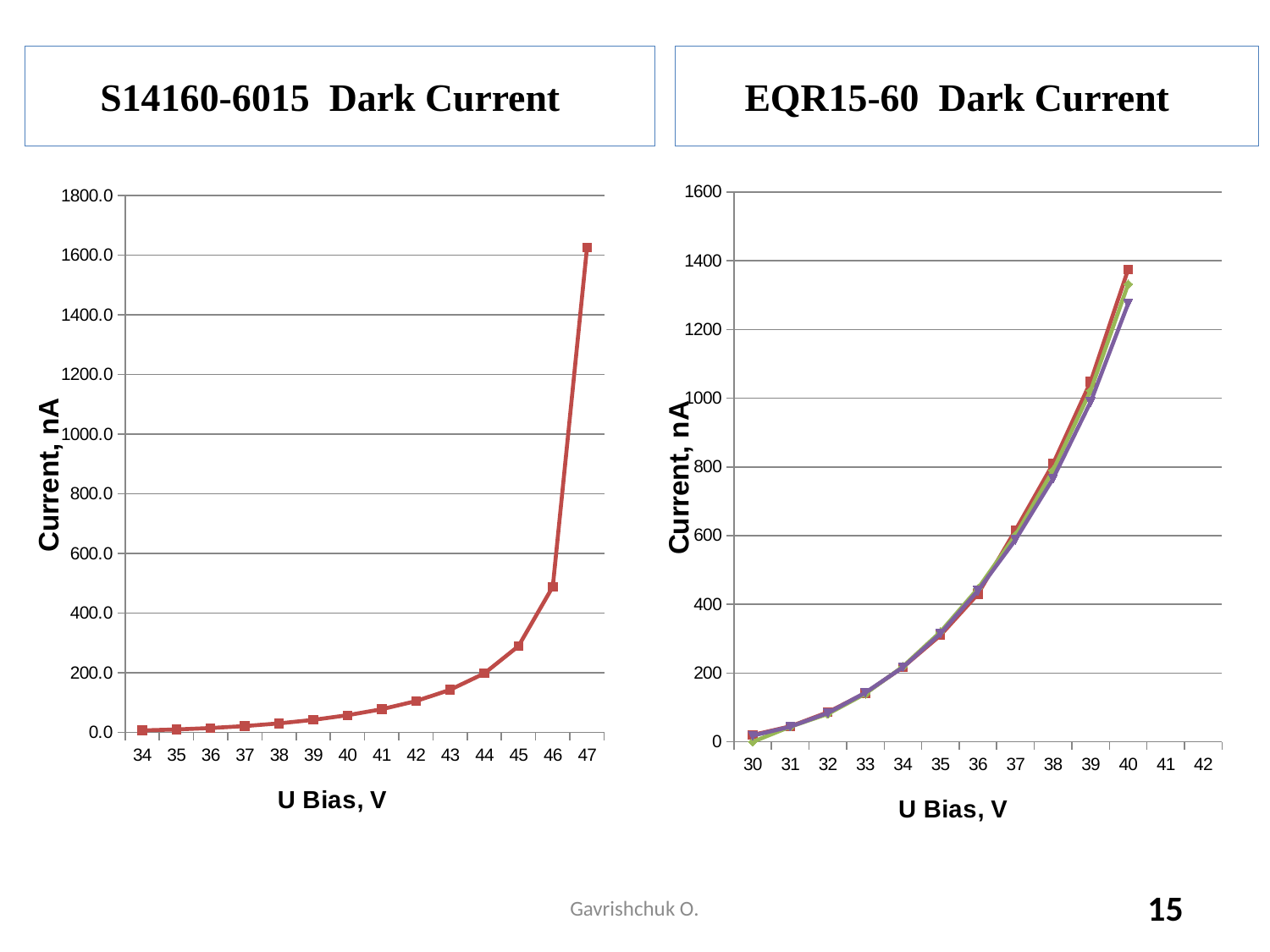
In the S14160-6015 Dark Current chart, does the current rise or fall as U Bias increases from 34 V to 47 V? rises What is the y-axis title of the EQR15-60 Dark Current chart? Current, nA In the EQR15-60 Dark Current chart, is the current at 40 V greater or less than 1200 nA? greater In the S14160-6015 Dark Current chart, at which U Bias value is the current highest? 47 In the EQR15-60 Dark Current chart, which has the larger current, 40 V or 39 V? 40 V In the S14160-6015 Dark Current chart, at which U Bias value is the current lowest? 34 What type of chart is the S14160-6015 Dark Current chart? line chart In the S14160-6015 Dark Current chart, is the current at 46 V greater or less than 600.0 nA? less In the S14160-6015 Dark Current chart, is the current at 45 V greater or less than 400.0 nA? less What is the x-axis title of the S14160-6015 Dark Current chart? U Bias, V In the S14160-6015 Dark Current chart, how many data points are plotted? 14